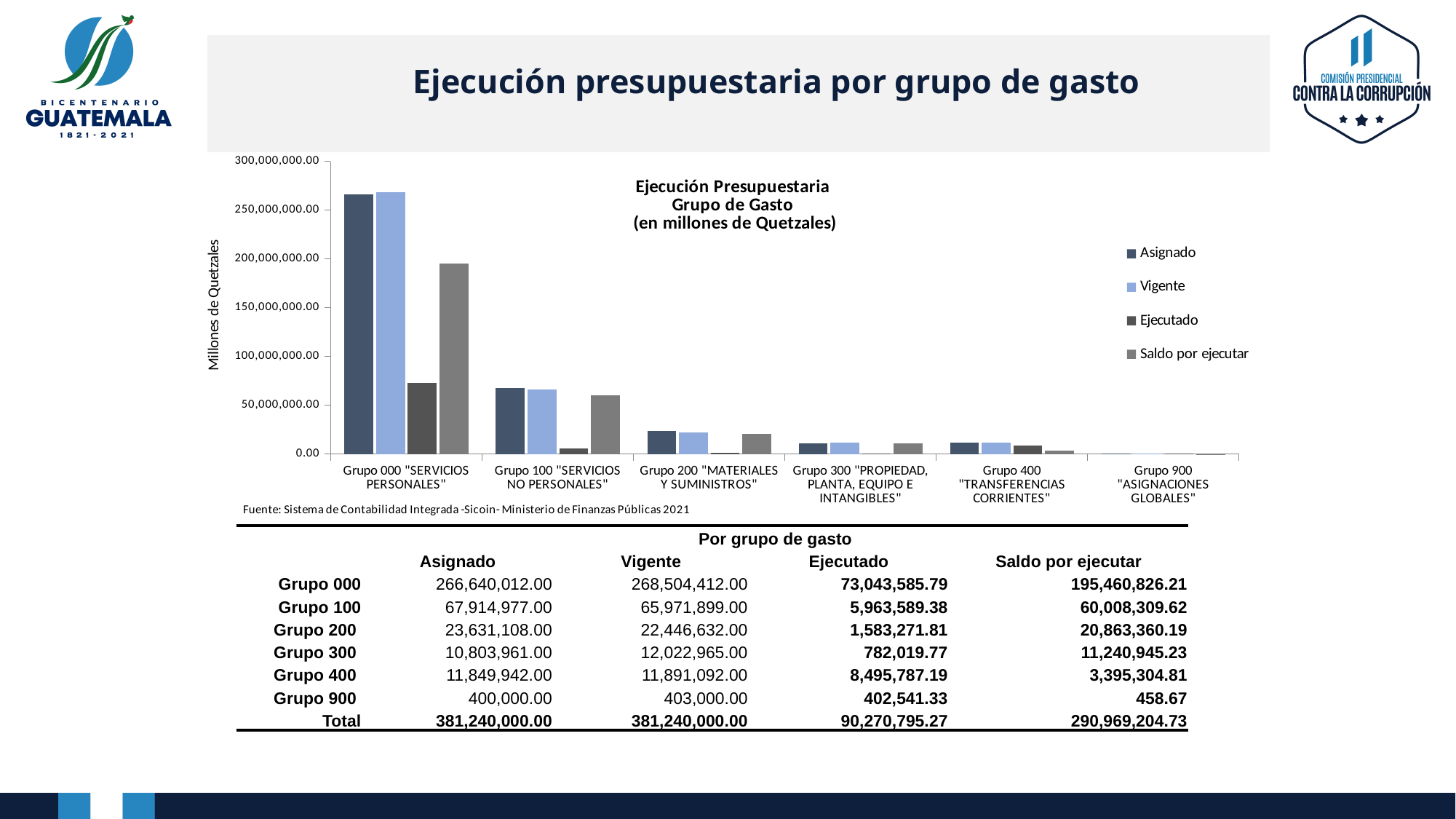
Is the Asignado value for Grupo 000 greater or less than 250,000,000.00? greater Do the Vigente bars rise or fall from left to right across the groups? fall What is the total Ejecutado across all groups? 90,270,795.27 Which group has the lowest Vigente bar? Grupo 900 "ASIGNACIONES GLOBALES" How much larger is the Vigente value than the Asignado value for Grupo 000? 1,864,400.00 For Grupo 000, which is larger, Ejecutado or Saldo por ejecutar? Saldo por ejecutar How many series does the chart legend list? 4 How many expense groups are shown along the x axis of the chart? 6 What kind of chart is shown on the slide? bar chart What is the Ejecutado value for Grupo 000? 73,043,585.79 Is the Saldo por ejecutar value for Grupo 100 greater or less than 50,000,000.00? greater Which group has the highest Asignado bar? Grupo 000 "SERVICIOS PERSONALES"